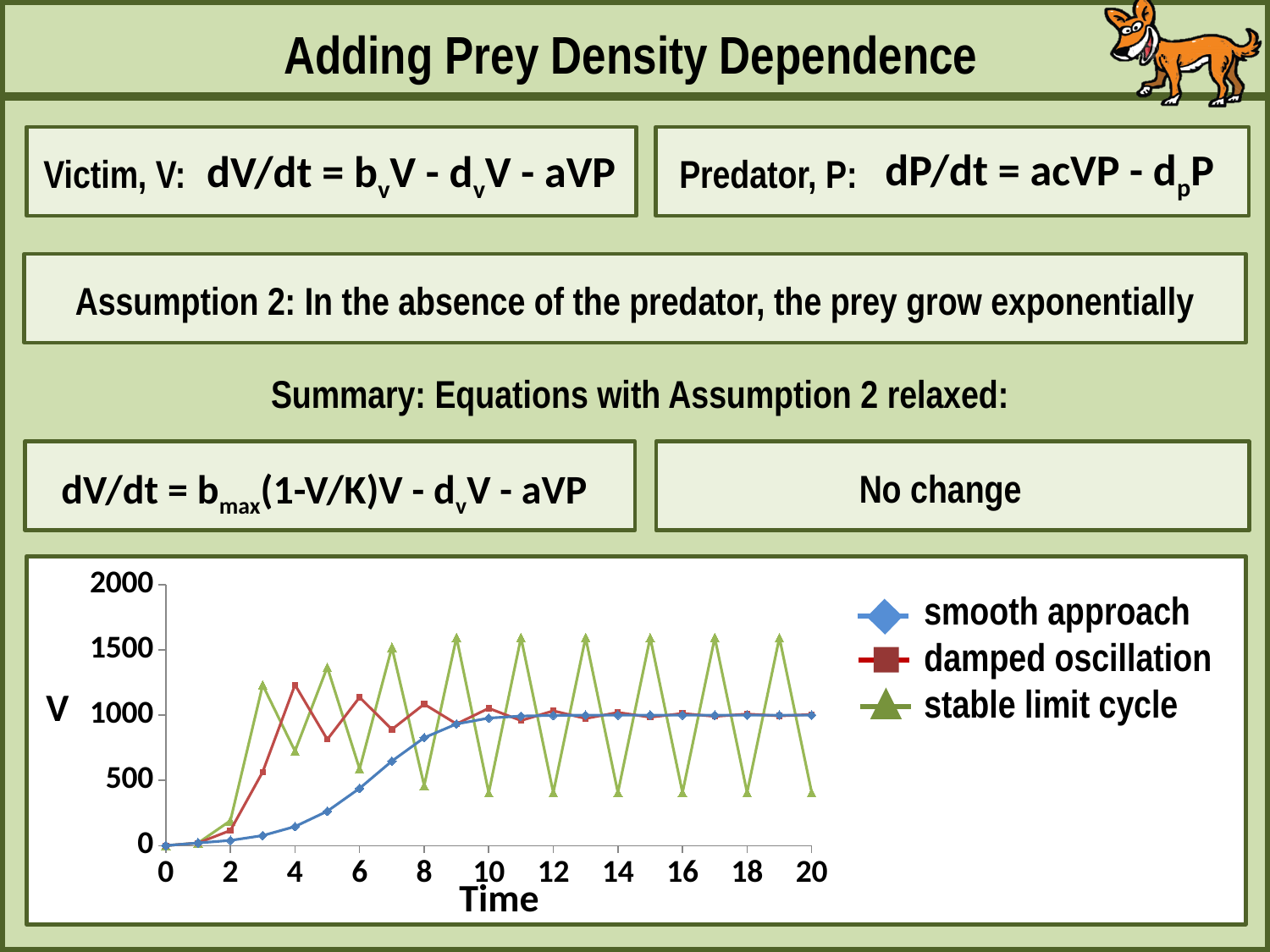
How many series does the chart legend list? 3 Is the value of the stable limit cycle series at Time 9 greater or less than 1500? greater Is the value of the smooth approach series at Time 6 greater or less than 500? less At Time 3, which series has the larger value: smooth approach or stable limit cycle? stable limit cycle What kind of chart is shown on the slide? line chart What are the three series named in the chart legend? smooth approach, damped oscillation, stable limit cycle Is the value of the damped oscillation series at Time 4 greater or less than 1000? greater At Time 6, which series has the larger value: damped oscillation or stable limit cycle? damped oscillation Does the smooth approach series rise or fall as Time increases from 0 to 10? rise What is the label of the x axis of the chart? Time What is the highest value shown on the V axis of the chart? 2000